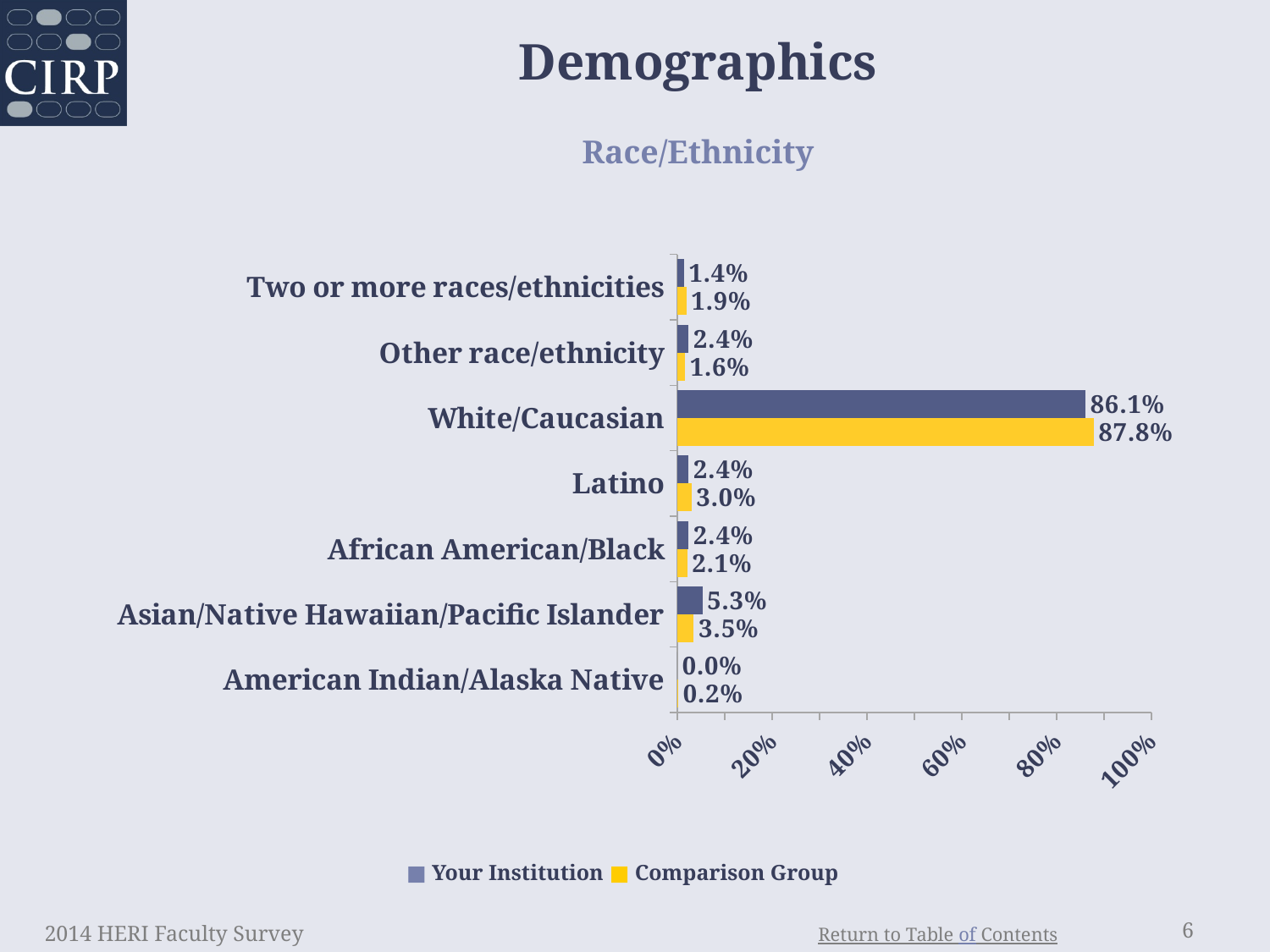
Which category has the highest value for Your Institution? White/Caucasian What is the value for Asian/Native Hawaiian/Pacific Islander for Your Institution? 5.3% How many race/ethnicity categories are shown on the chart? 7 What is the difference between the Comparison Group and Your Institution values for White/Caucasian? 1.7% Which category has the lowest value for Your Institution? American Indian/Alaska Native What is the value for American Indian/Alaska Native for the Comparison Group? 0.2% Is the Comparison Group value for White/Caucasian greater or less than 80%? greater What is the value for Latino for the Comparison Group? 3.0% What kind of chart is shown on the slide? Bar chart What is the value for White/Caucasian for Your Institution? 86.1% How many series does the legend list? 2 Which is larger for Asian/Native Hawaiian/Pacific Islander: Your Institution or the Comparison Group? Your Institution